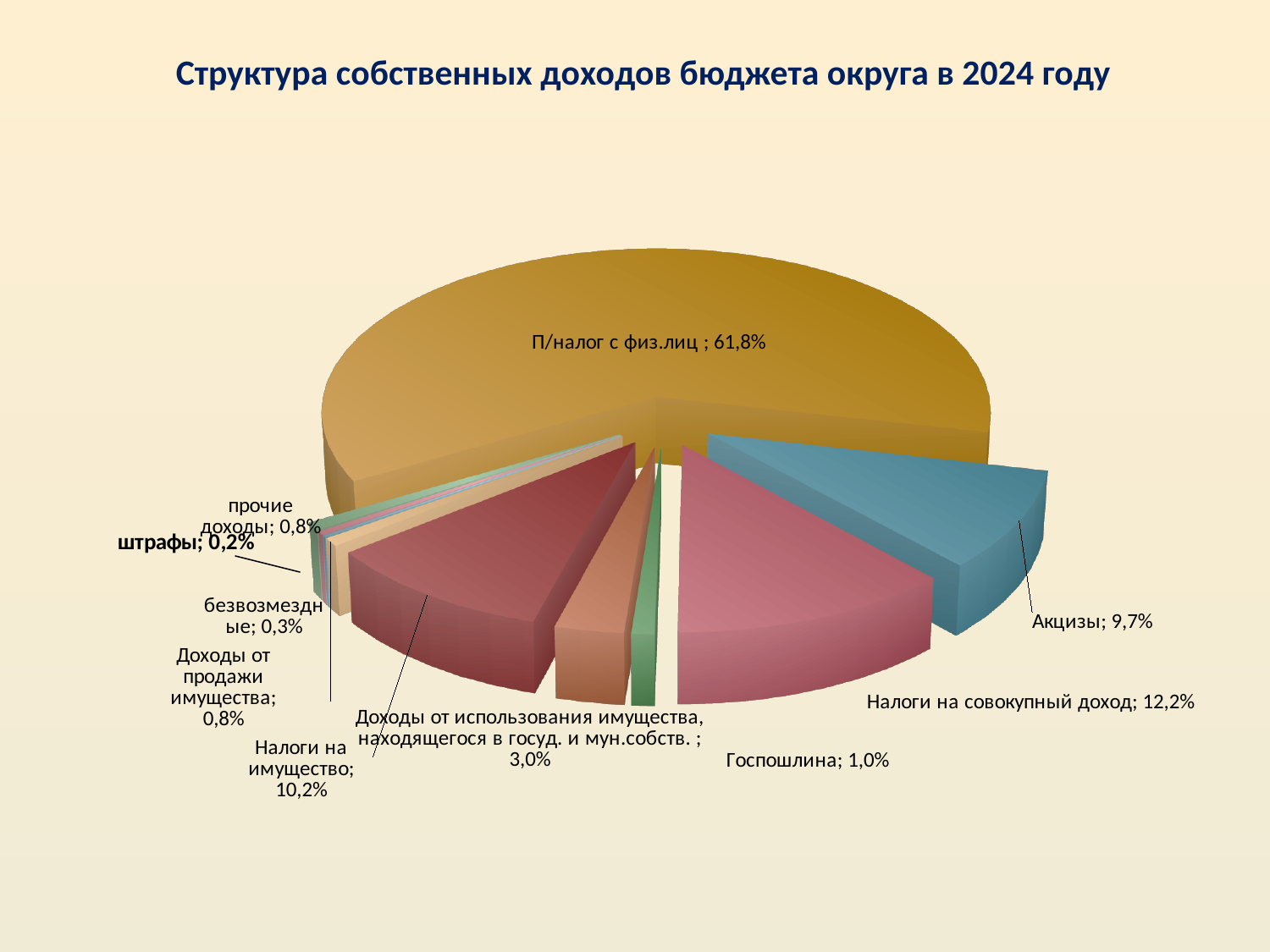
What is the value shown for "Госпошлина"? 1,0% What is the title of the chart? Структура собственных доходов бюджета округа в 2024 году How many slices does the pie chart have? 10 What is the value shown for "Налоги на имущество"? 10,2% What is the value shown for "Акцизы"? 9,7% What kind of chart is shown on the slide? pie chart What is the value shown for "Налоги на совокупный доход"? 12,2% Which is larger: "Налоги на имущество" or "Акцизы"? Налоги на имущество What is the difference between the shares of "Налоги на совокупный доход" and "Акцизы"? 2,5% What share does "П/налог с физ.лиц" have in the pie? 61,8% Which category has the smallest share of the pie? штрафы Which category has the largest share of the pie? П/налог с физ.лиц